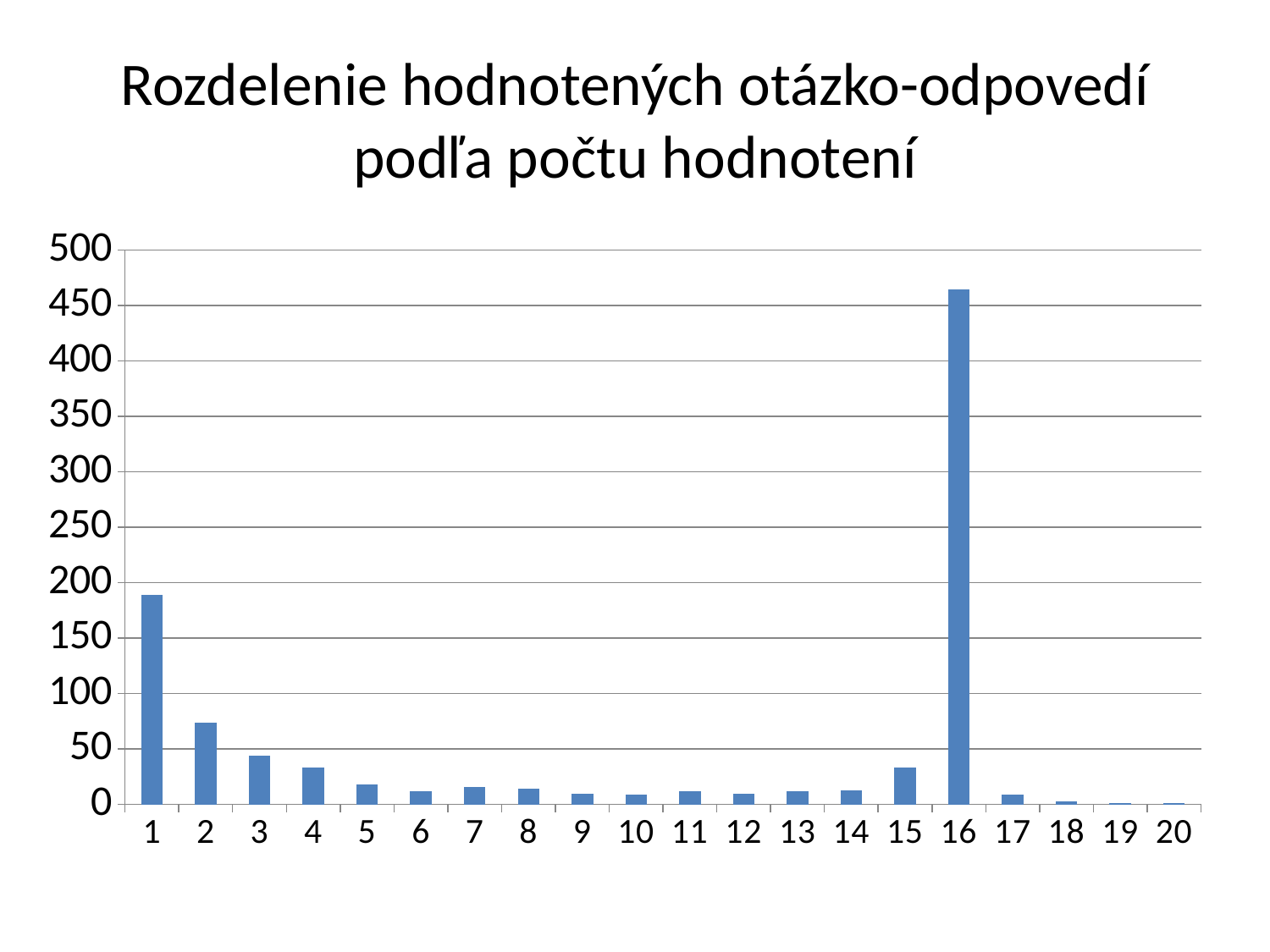
How many categories are shown on the x axis of the chart? 20 Is the value for category 1 greater or less than 200? less What is the title of the chart? Rozdelenie hodnotených otázko-odpovedí podľa počtu hodnotení Which is larger, the value for category 1 or the value for category 2? 1 Which is larger, the value for category 3 or the value for category 4? 3 Is the value for category 1 greater or less than 150? greater What kind of chart is shown on the slide? bar chart Is the value for category 2 greater or less than 50? greater Which category has the highest bar in the chart? 16 Do the values rise or fall from category 1 to category 5? fall